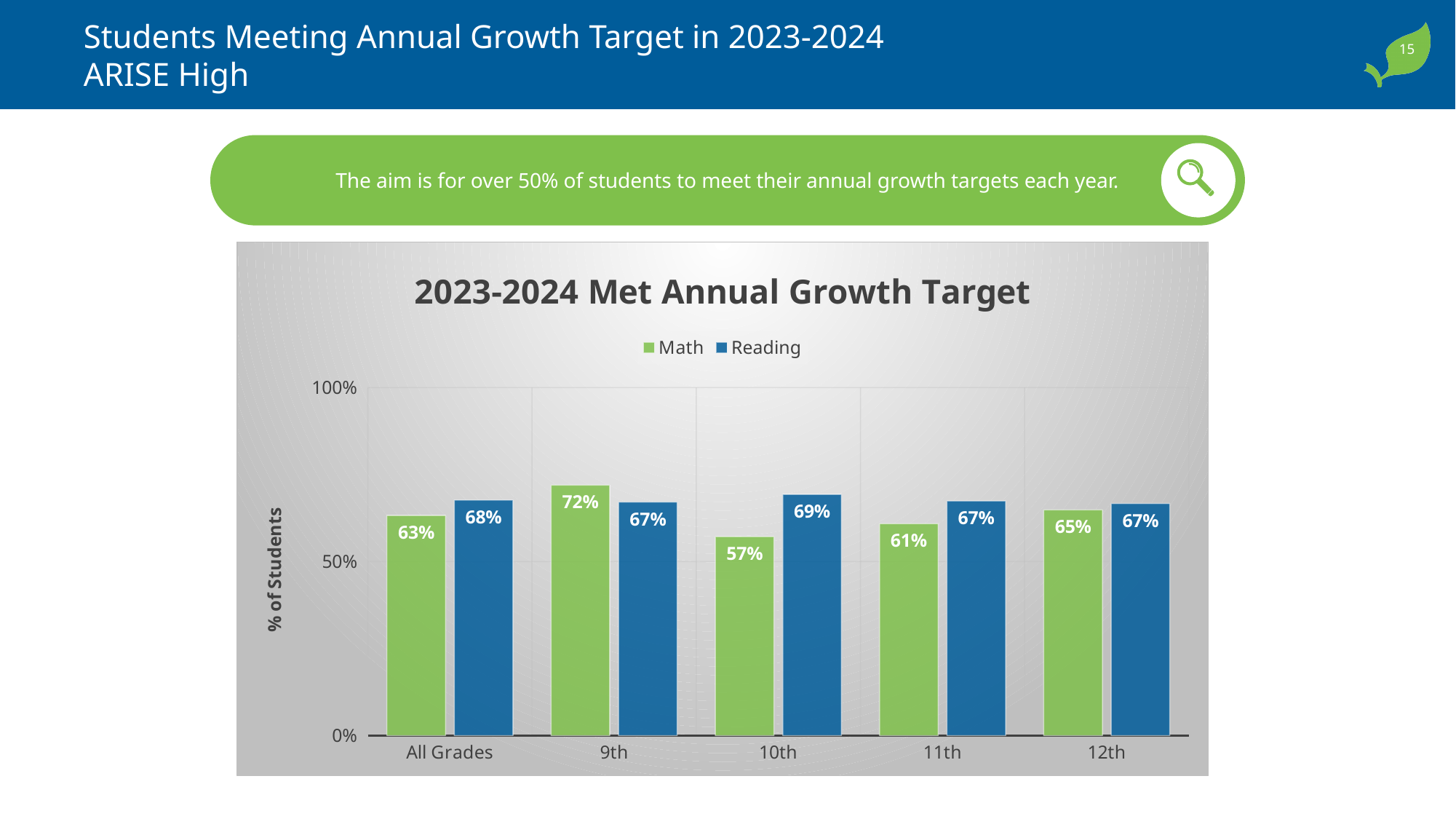
What is the Math value for 9th grade? 72% For 9th grade, which is larger, Math or Reading? Math Which grade category has the highest Math value? 9th What is the Math value for All Grades? 63% How many grade categories are shown on the x axis? 5 What is the Reading value for 10th grade? 69% What kind of chart is shown? Bar chart Is the Math value for 10th grade greater or less than 50%? greater What is the difference between the Reading and Math values for 10th grade? 12% Which grade category has the lowest Math value? 10th How many series does the legend list? 2 What is the title of the chart? 2023-2024 Met Annual Growth Target